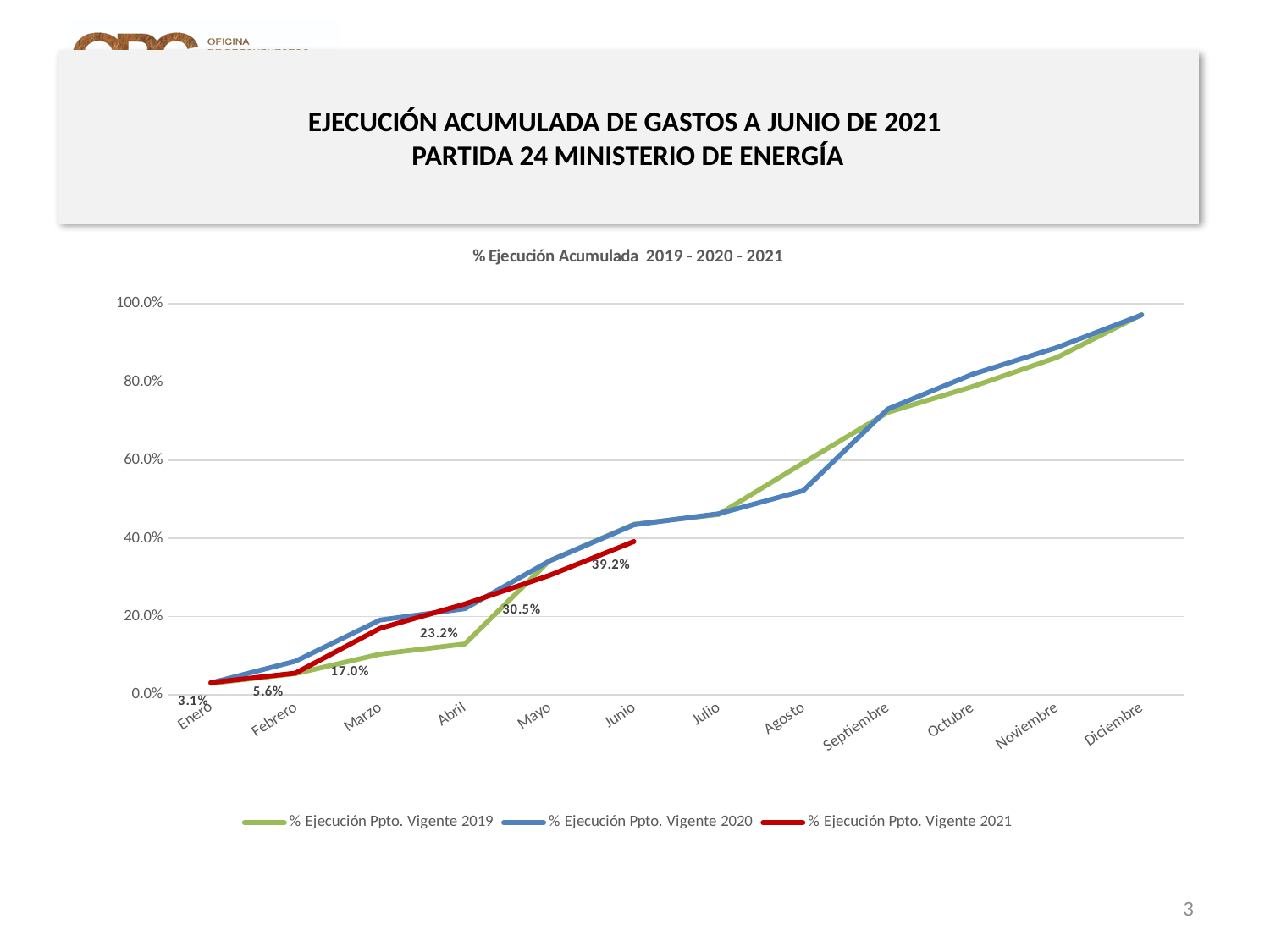
How many series does the legend list? 3 How many months are shown on the x axis? 12 What is the value of % Ejecución Ppto. Vigente 2021 for Junio? 39.2% In which month does the % Ejecución Ppto. Vigente 2021 series reach its highest value? Junio Is the value for % Ejecución Ppto. Vigente 2020 in Diciembre greater or less than 80.0%? greater What is the value of % Ejecución Ppto. Vigente 2021 for Marzo? 17.0% What kind of chart is shown on the slide? Line chart What is the value of % Ejecución Ppto. Vigente 2021 for Enero? 3.1% In Abril, which series has the larger value: % Ejecución Ppto. Vigente 2019 or % Ejecución Ppto. Vigente 2020? % Ejecución Ppto. Vigente 2020 Does the % Ejecución Ppto. Vigente 2021 series rise or fall from Enero to Junio? Rise What is the difference between the 2021 values for Junio and Mayo? 8.7% What is the title of the chart? % Ejecución Acumulada 2019 - 2020 - 2021